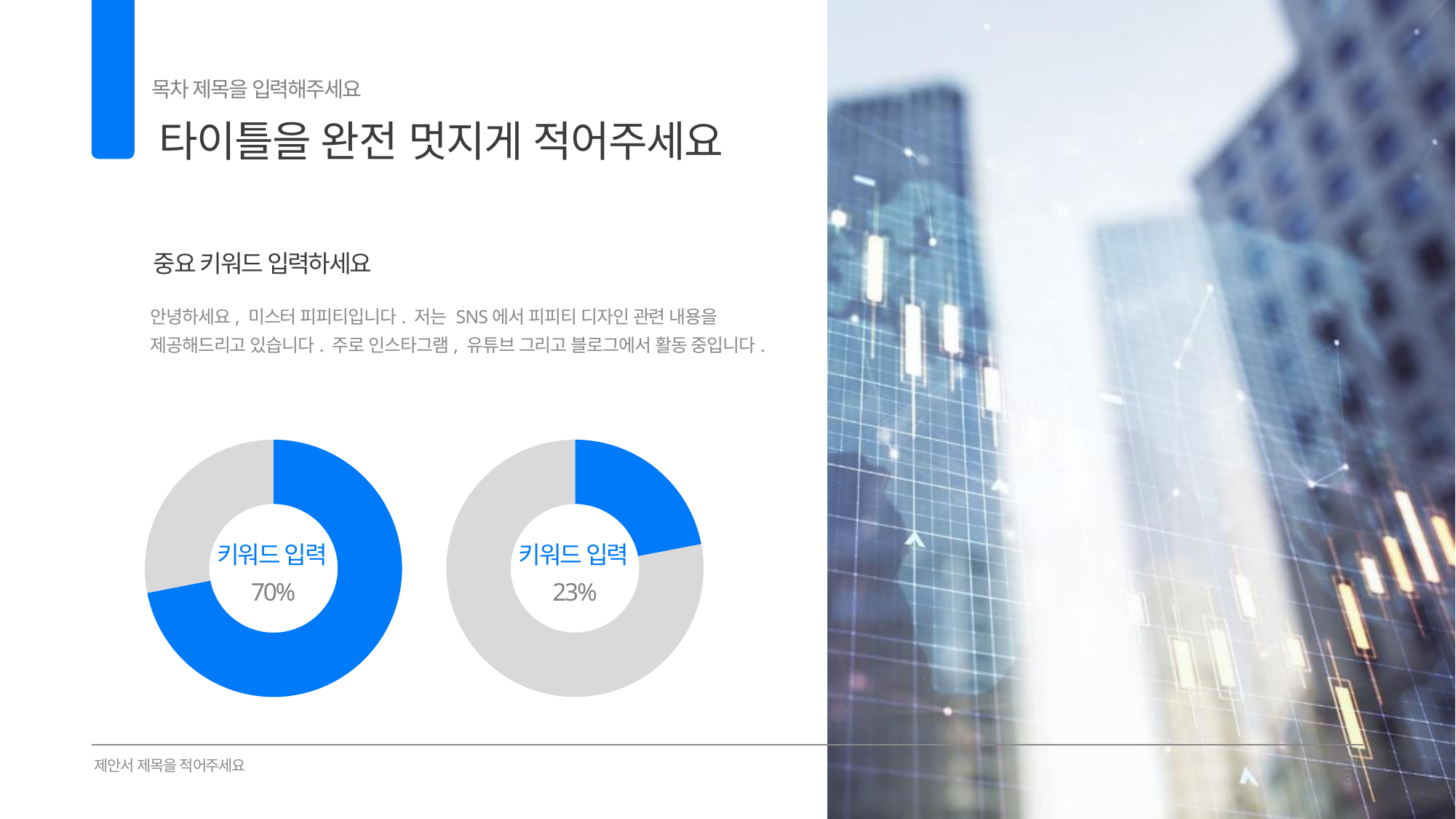
In the left donut chart, what share of the ring is not filled in blue? 30% What kind of charts are shown on the slide? donut (pie) charts Which donut chart shows the larger percentage, the left one or the right one? the left one What colour is used for the highlighted (filled) segment in both donut charts? blue What percentage is shown in the center of the left donut chart? 70% What is the difference between the percentage in the left donut chart and the percentage in the right donut chart? 47 percentage points What percentage is shown in the center of the right donut chart? 23% In the right donut chart, what share of the ring is not filled in blue? 77% What label text appears in the center of the left donut chart above the percentage? 키워드 입력 How many donut charts are on the slide? 2